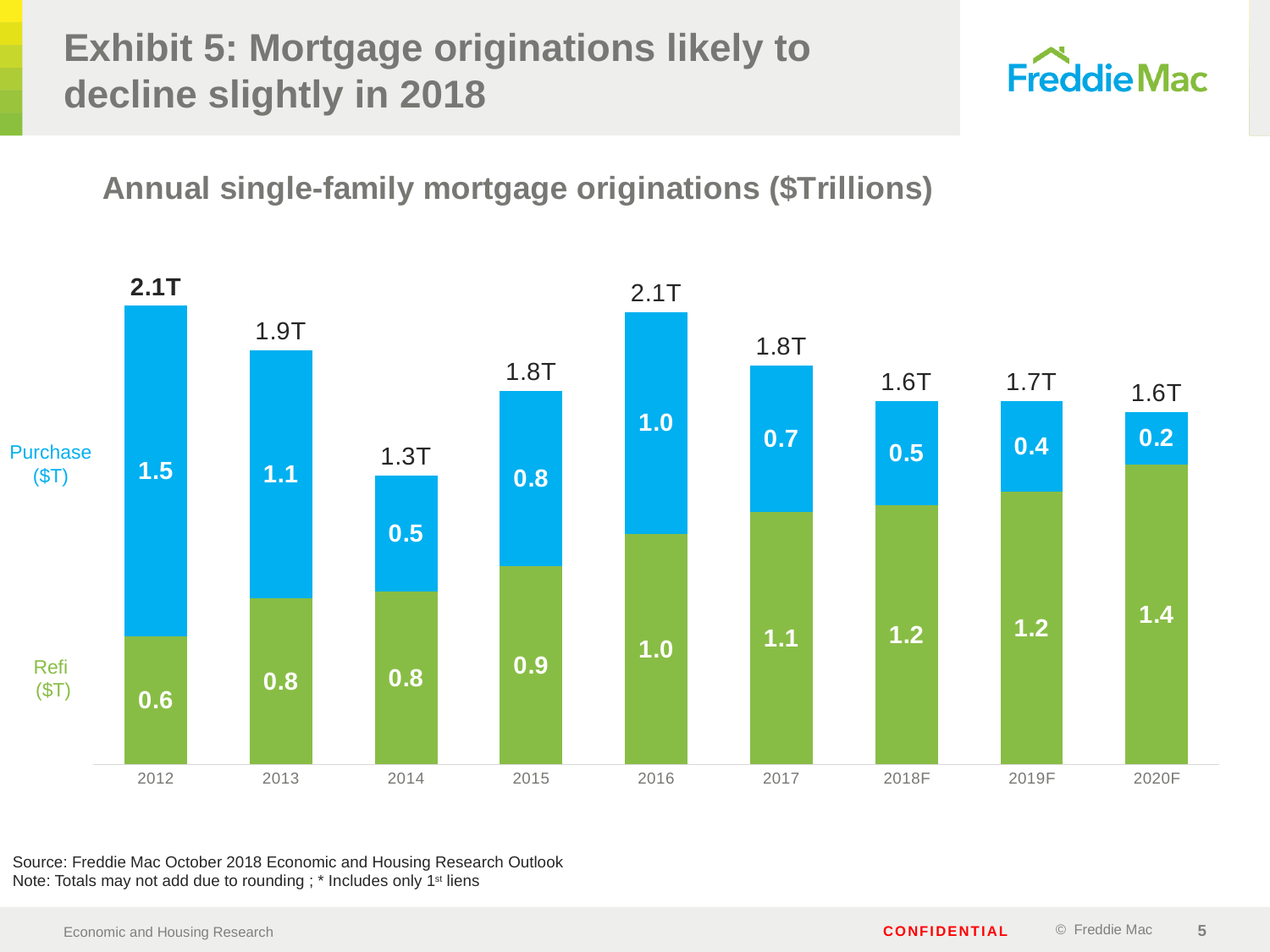
What is the total annual origination shown above the 2014 bar? 1.3T Which year has the highest Refi value? 2020F How many years are shown on the x axis? 9 Does the Purchase value rise or fall from 2016 to 2020F? Fall Which is larger, the Refi value for 2015 or the Refi value for 2014? 2015 What is the Refi value for 2017? 1.1 How many series does the chart show? 2 What is the difference between the Purchase values for 2012 and 2013? 0.4 What is the Purchase value for 2012? 1.5 What kind of chart is this? Stacked bar chart Which year has the lowest Purchase value? 2020F What is the title of the chart? Annual single-family mortgage originations ($Trillions)